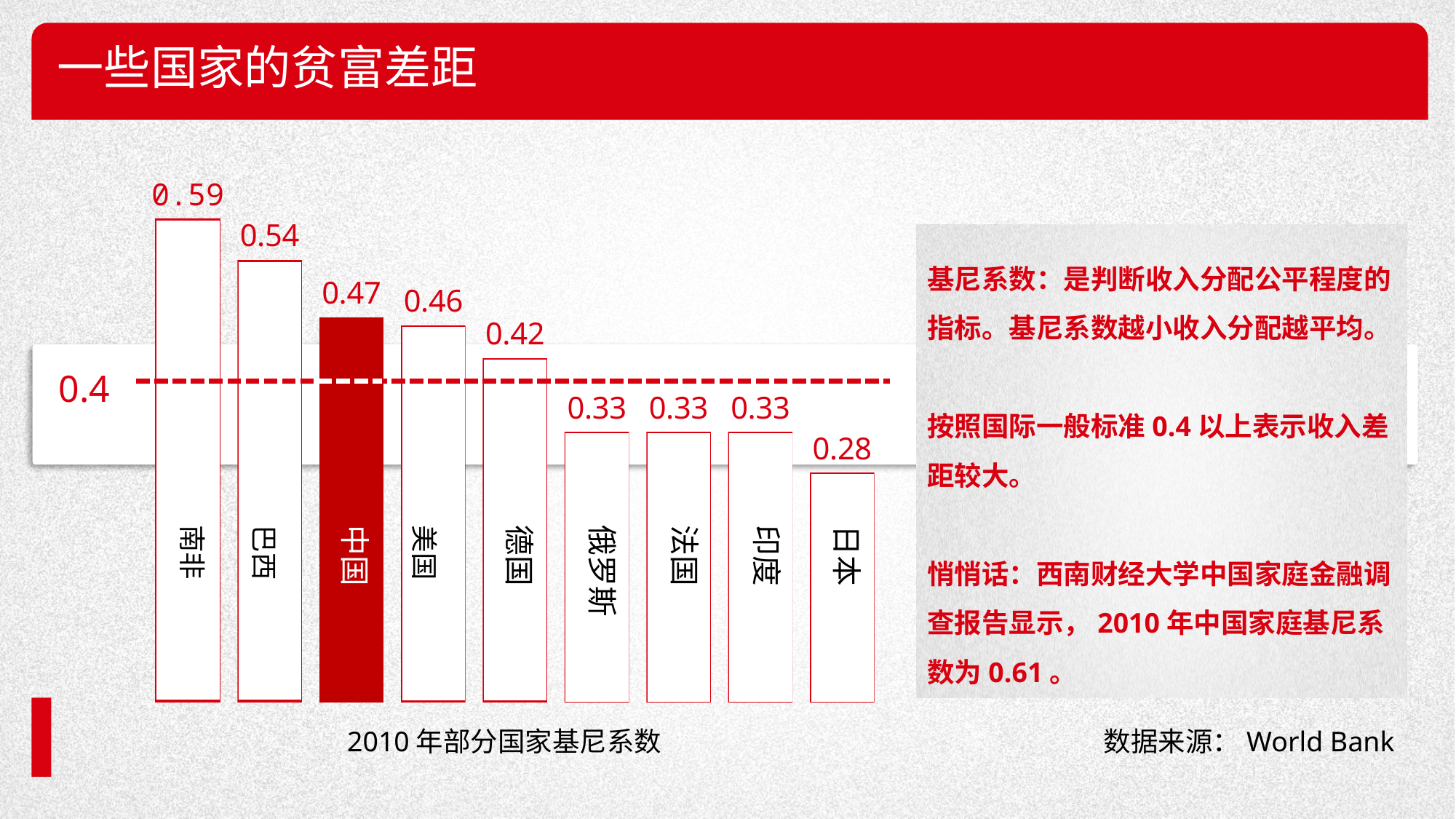
What is the value shown for 南非 (South Africa)? 0.59 How many countries are shown in the chart? 9 What is the difference between the values for 南非 and 中国? 0.12 What is the title printed below the chart? 2010年部分国家基尼系数 Is the value for 德国 greater or less than 0.4? greater What is the value shown for 日本 (Japan)? 0.28 Which country has the lowest Gini coefficient in the chart? 日本 Which country has the highest Gini coefficient in the chart? 南非 What is the Gini coefficient shown for 中国 (China)? 0.47 Which has a larger value, 美国 or 德国? 美国 What is the difference between the values for 巴西 and 日本? 0.26 What kind of chart is shown on the slide? bar chart